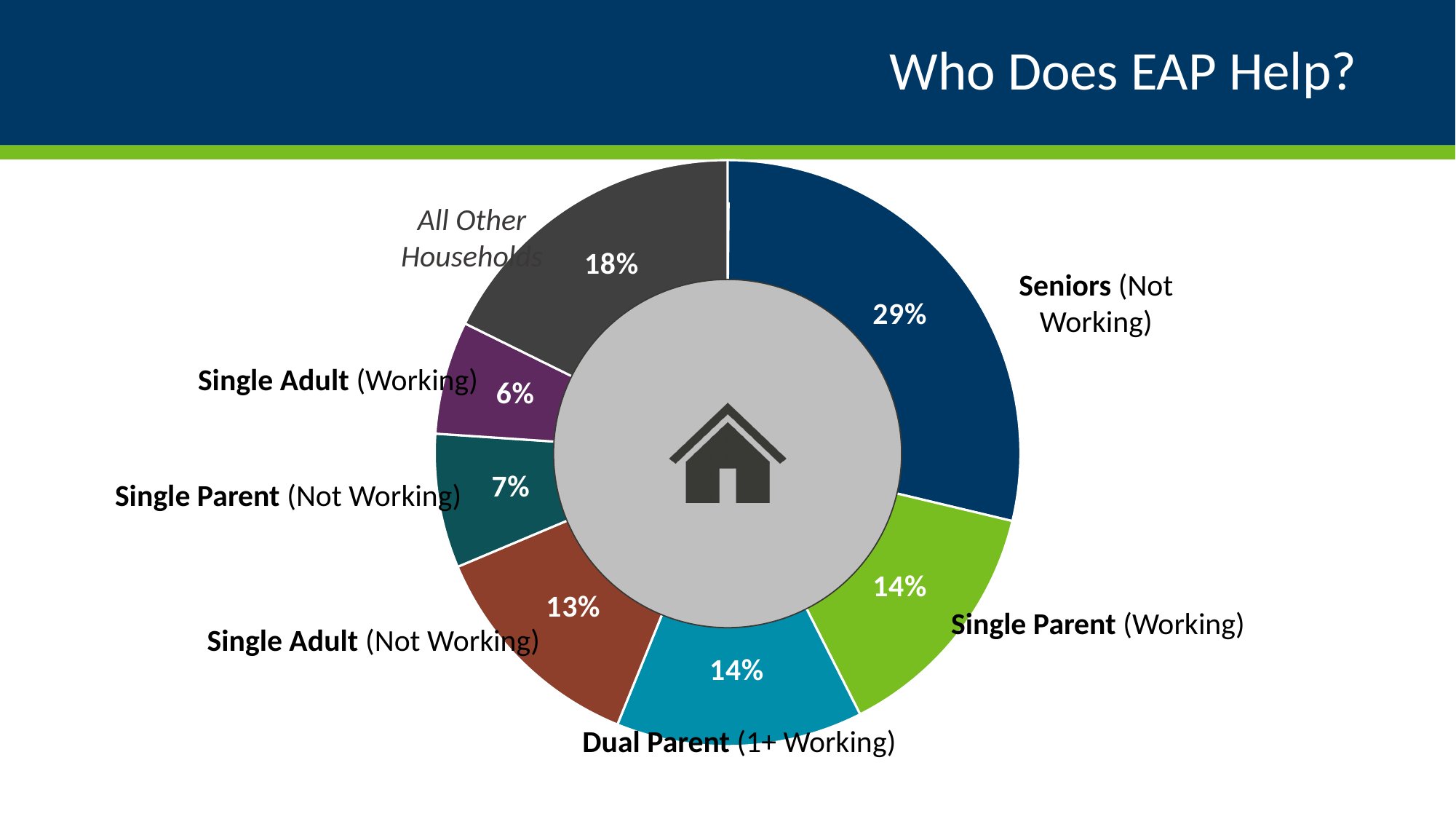
Which is larger, the share for Single Adult (Not Working) or the share for Single Parent (Not Working)? Single Adult (Not Working) What is the difference in percentage points between Seniors (Not Working) and All Other Households? 11 Which category has the largest slice of the pie? Seniors (Not Working) Which two categories both have a share of 14%? Single Parent (Working) and Dual Parent (1+ Working) What percentage is shown for Single Parent (Not Working)? 7% What share of the pie is labelled Single Adult (Not Working)? 13% How many categories are shown in the pie chart? 7 What is the title of the slide containing the chart? Who Does EAP Help? Which category has the smallest slice of the pie? Single Adult (Working) What percentage of households helped by EAP are Seniors (Not Working)? 29% What percentage is shown for All Other Households? 18% What kind of chart is shown on the slide? Doughnut chart